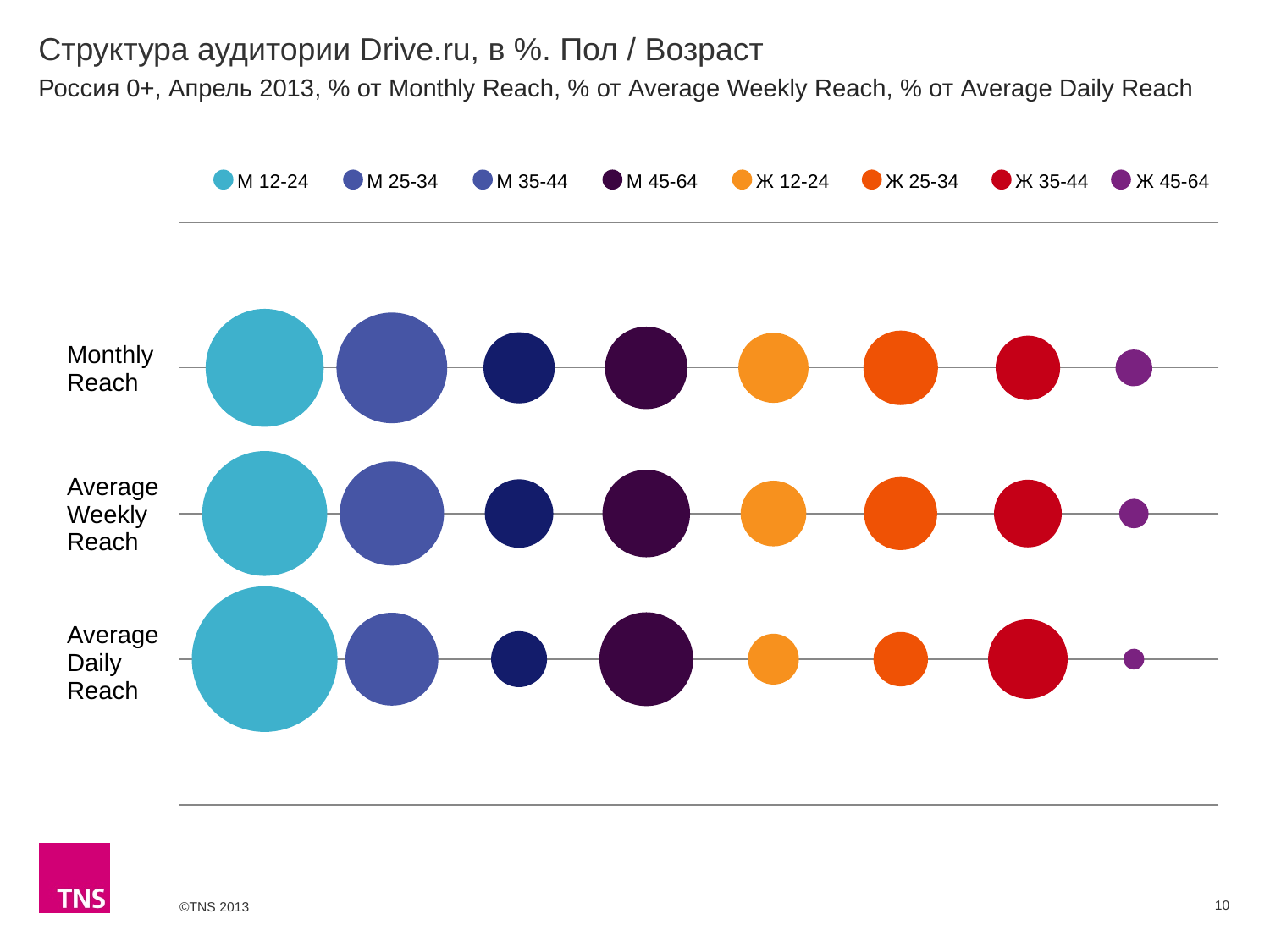
Which group has the largest bubble in the Average Daily Reach row? М 12-24 What kind of chart is shown on the slide? Bubble chart In the Average Daily Reach row, which bubble is larger: Ж 35-44 or Ж 12-24? Ж 35-44 In the Monthly Reach row, which bubble is larger: М 25-34 or Ж 25-34? М 25-34 How many reach categories (rows) are plotted on the chart? 3 In the Average Daily Reach row, which bubble is larger: М 45-64 or М 35-44? М 45-64 Which legend entry is shown in red? Ж 35-44 Which group has the smallest bubble in the Monthly Reach row? Ж 45-64 Which group has the smallest bubble in the Average Weekly Reach row? Ж 45-64 How many series does the legend list? 8 Which group has the largest bubble in the Monthly Reach row? М 12-24 What is the title of the chart on the slide? Структура аудитории Drive.ru, в %. Пол / Возраст